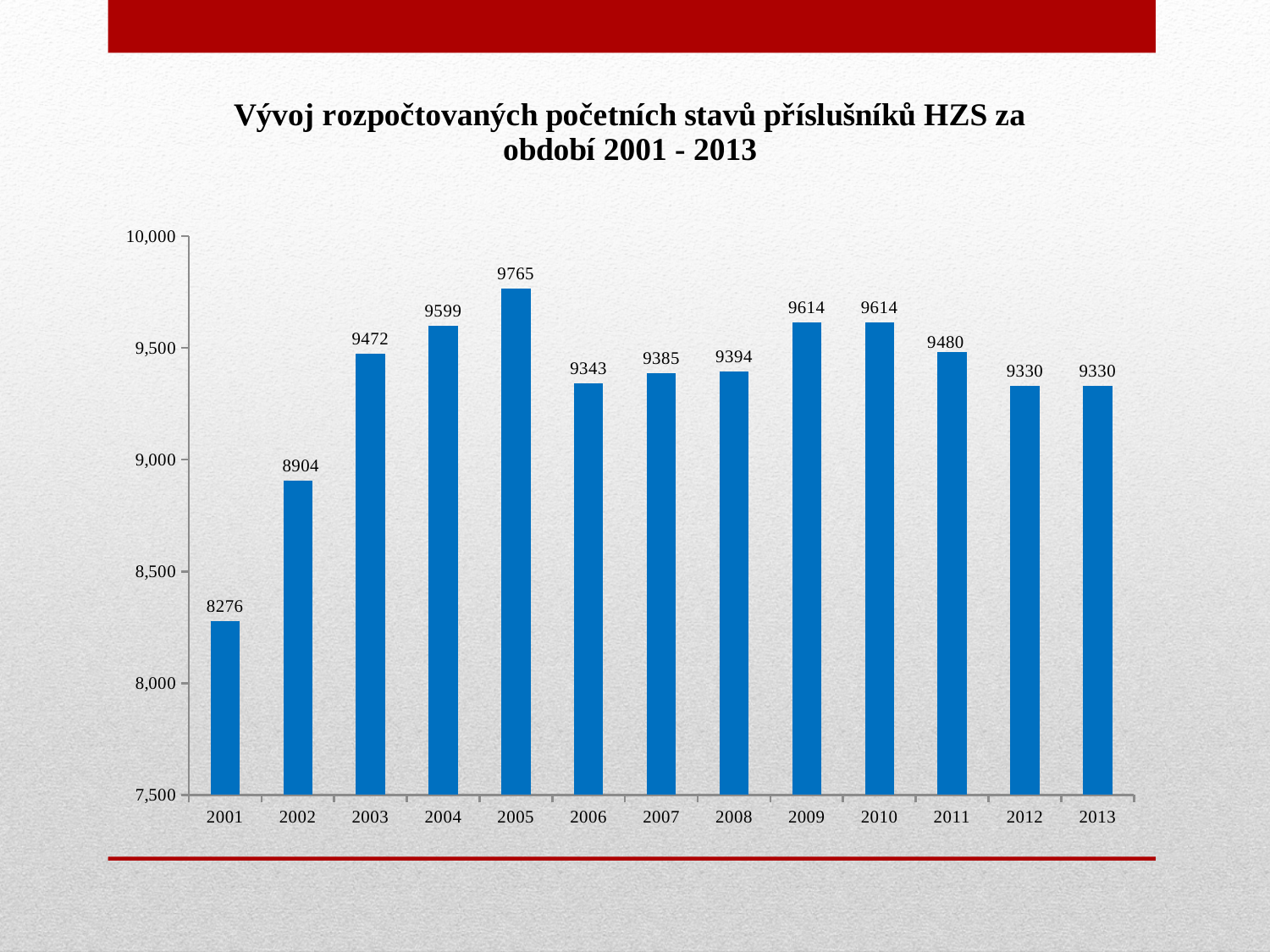
Which year has the lowest value? 2001 How many years are shown on the x axis? 13 What kind of chart is this? bar chart Is the value for 2002 greater or less than 9,000? less What is the difference between the values for 2005 and 2001? 1489 What is the value for 2011? 9480 What is the value for 2005? 9765 Which is larger, the value for 2004 or the value for 2006? 2004 Which year has the highest value? 2005 Do the values rise or fall from 2001 to 2005? rise What is the difference between the values for 2010 and 2011? 134 What is the value for 2001? 8276